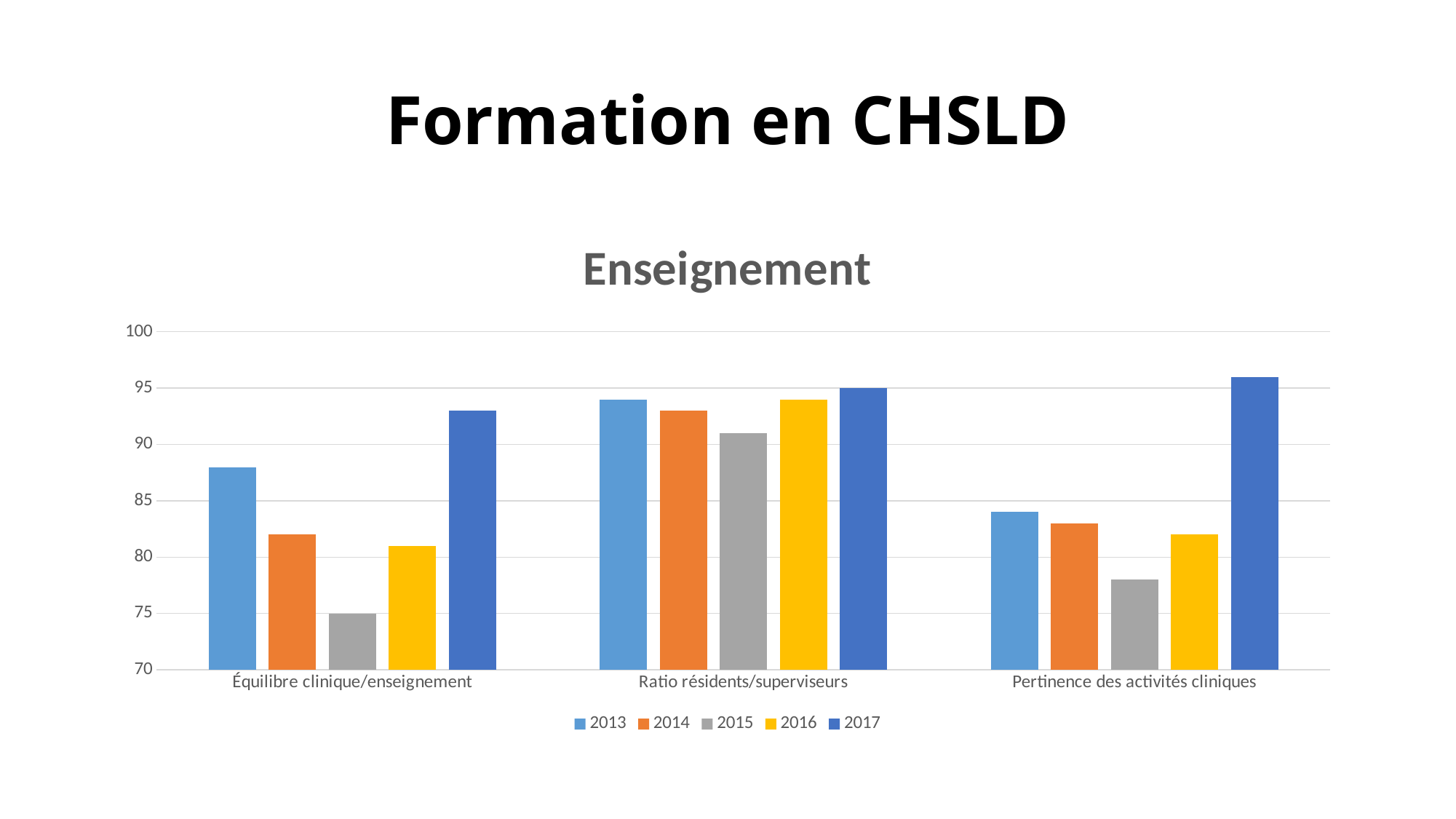
Is the value for 2013 in the Équilibre clinique/enseignement category greater or less than 90? less In the Ratio résidents/superviseurs category, which is larger: the value for 2013 or the value for 2015? 2013 Which year is shown in grey in the legend? 2015 How many categories are shown on the x axis? 3 Is the value for 2017 in the Pertinence des activités cliniques category greater or less than 95? greater Which year has the lowest value in the Équilibre clinique/enseignement category? 2015 Which year has the highest value in the Pertinence des activités cliniques category? 2017 What is the value for 2015 in the Équilibre clinique/enseignement category? 75 What kind of chart is shown on the slide? bar chart What is the value for 2017 in the Ratio résidents/superviseurs category? 95 What is the title of the chart? Enseignement How many series does the legend list? 5